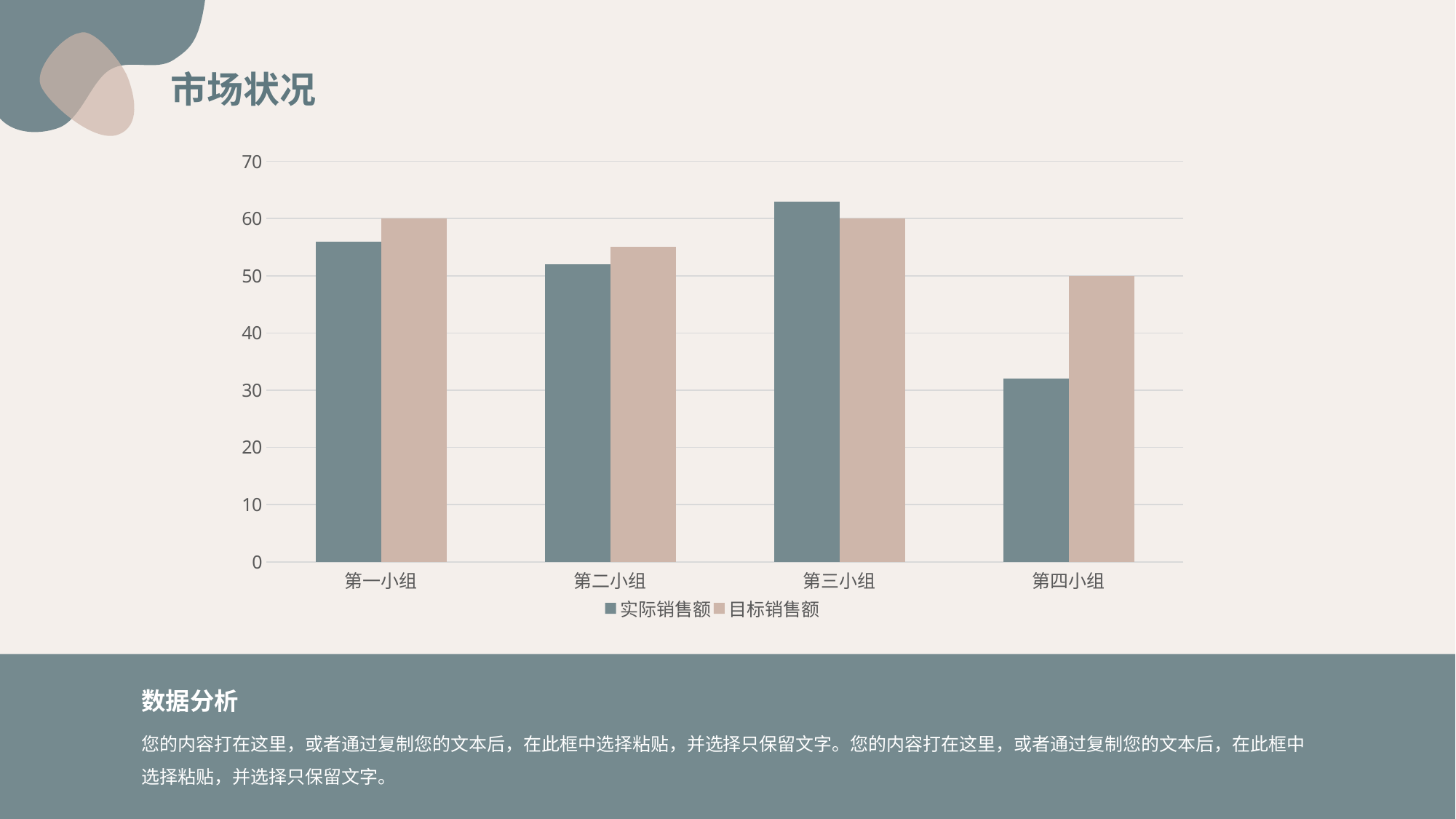
Which category has the lowest 实际销售额? 第四小组 Is the 实际销售额 value for 第三小组 greater or less than 60? greater What kind of chart is shown on the slide? bar chart For 第四小组, which is larger: 实际销售额 or 目标销售额? 目标销售额 What is the 目标销售额 value for 第一小组? 60 How many series does the legend list? 2 How many categories are shown on the x axis? 4 Which category has the highest 实际销售额? 第三小组 Is the 实际销售额 value for 第四小组 greater or less than 40? less What is the 目标销售额 value for 第四小组? 50 What is the title of the slide containing the chart? 市场状况 Which category has the lowest 目标销售额? 第四小组